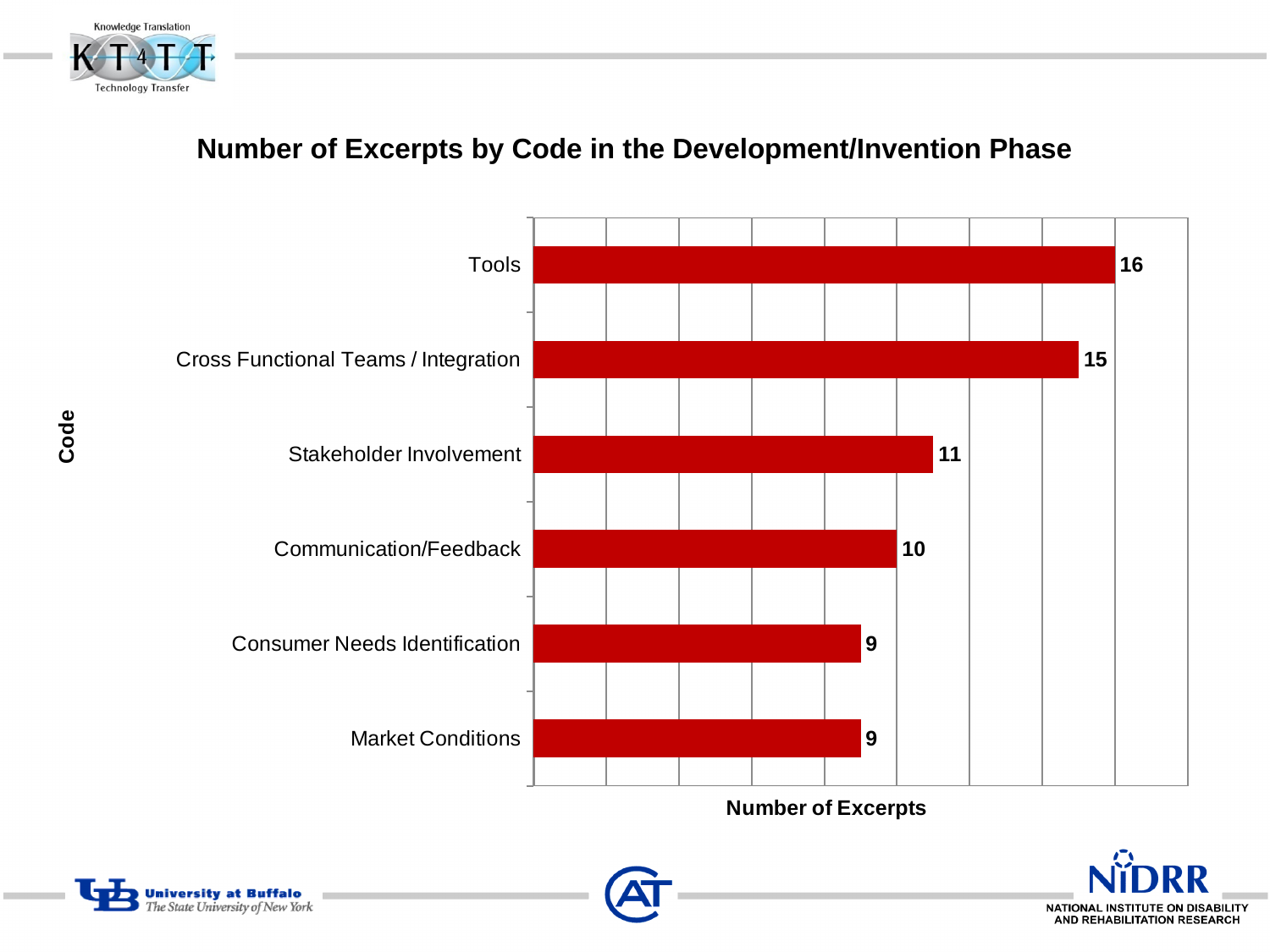
What is the title of the chart? Number of Excerpts by Code in the Development/Invention Phase Which two codes share the same number of excerpts? Consumer Needs Identification and Market Conditions What is the number of excerpts for Communication/Feedback? 10 What is the difference in number of excerpts between Tools and Cross Functional Teams / Integration? 1 Which code has the highest number of excerpts? Tools What is the number of excerpts for Tools? 16 What kind of chart is shown on the slide? Bar chart What is the number of excerpts for Stakeholder Involvement? 11 What is the label of the horizontal axis? Number of Excerpts What is the difference in number of excerpts between Cross Functional Teams / Integration and Consumer Needs Identification? 6 Which has more excerpts, Stakeholder Involvement or Communication/Feedback? Stakeholder Involvement How many codes are shown in the chart? 6